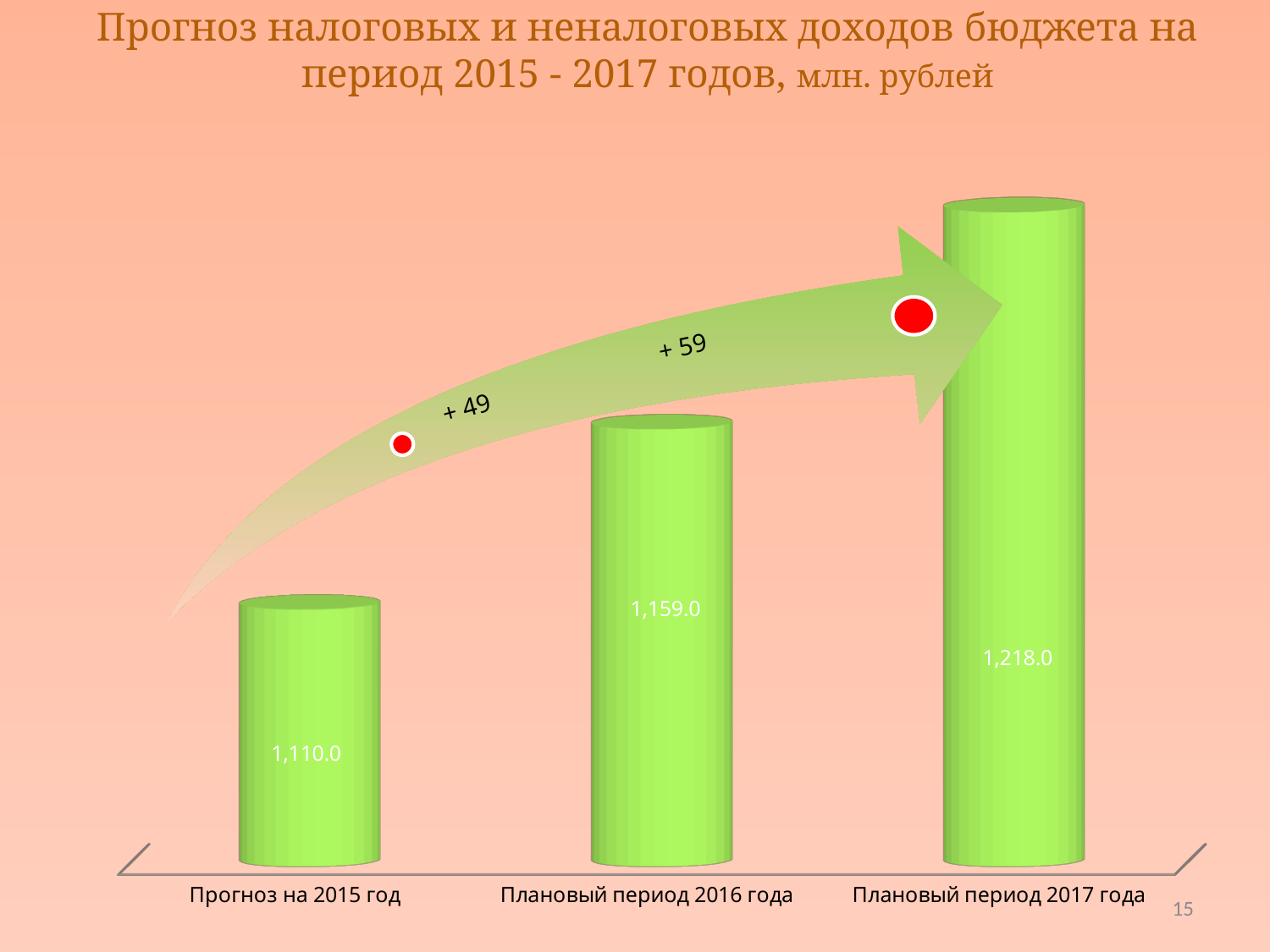
Do the values rise or fall from 2015 to 2017? Rise What is the value for Плановый период 2017 года? 1,218.0 What is the difference between the values for Плановый период 2017 года and Прогноз на 2015 год? 108.0 What kind of chart is shown on the slide? Bar chart What is the value for Плановый период 2016 года? 1,159.0 Which is larger, the value for Прогноз на 2015 год or the value for Плановый период 2016 года? Плановый период 2016 года What is the difference between the values for Плановый период 2017 года and Плановый период 2016 года? 59.0 How many categories are shown in the chart? 3 Which category has the highest value? Плановый период 2017 года What is the value for Прогноз на 2015 год? 1,110.0 Which category has the lowest value? Прогноз на 2015 год What is the difference between the values for Плановый период 2016 года and Прогноз на 2015 год? 49.0